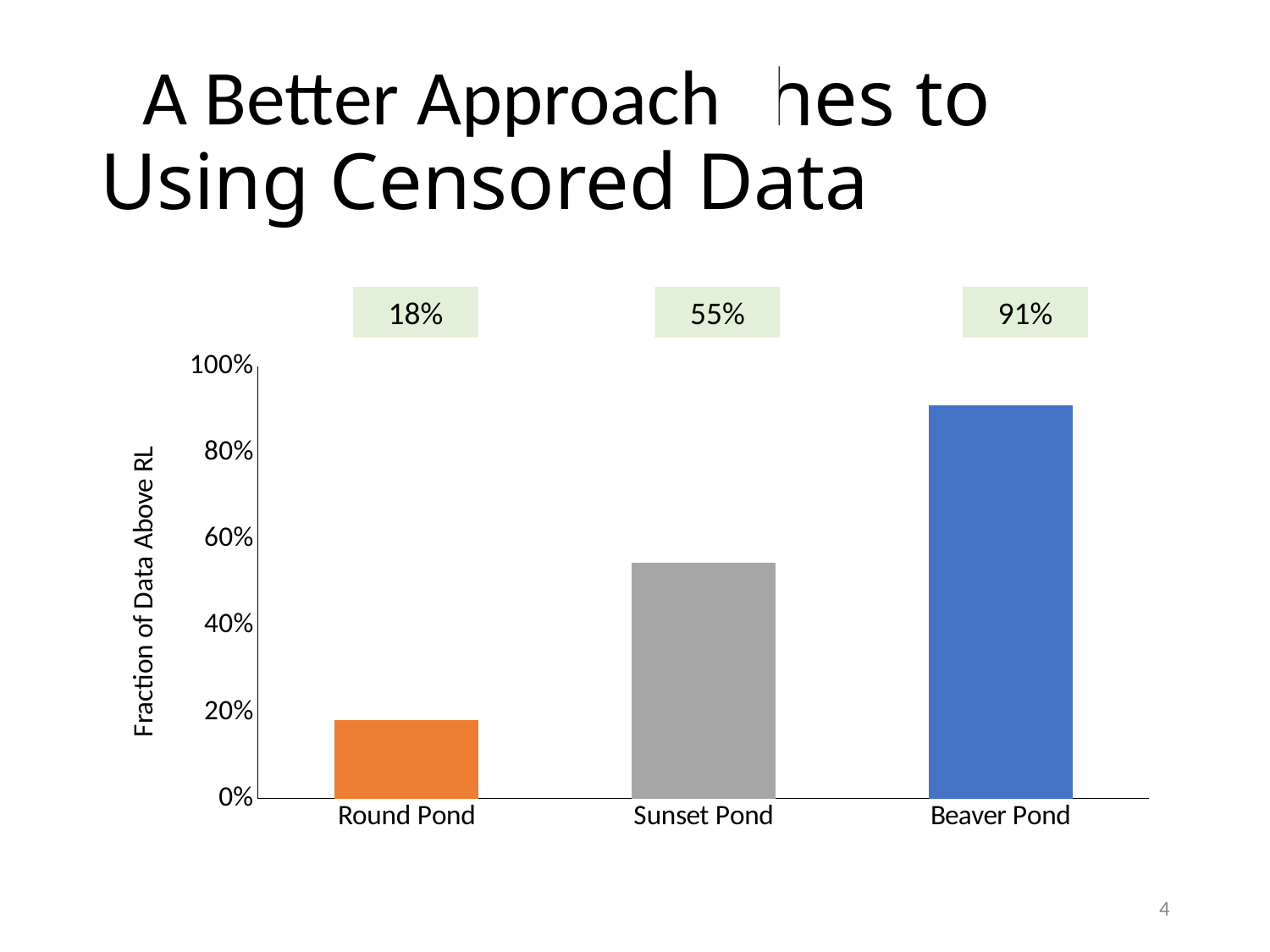
What is the value for Sunset Pond? 55% What kind of chart is shown on the slide? bar chart Which pond has the lowest fraction of data above RL? Round Pond What is the difference between the values for Beaver Pond and Round Pond? 73% What is the label of the vertical axis? Fraction of Data Above RL How many categories are shown on the x axis? 3 Is the value for Sunset Pond greater or less than 60%? less What is the difference between the values for Sunset Pond and Round Pond? 37% Which pond has the highest fraction of data above RL? Beaver Pond Which is larger, the value for Sunset Pond or the value for Round Pond? Sunset Pond What is the value for Round Pond? 18% What is the value for Beaver Pond? 91%